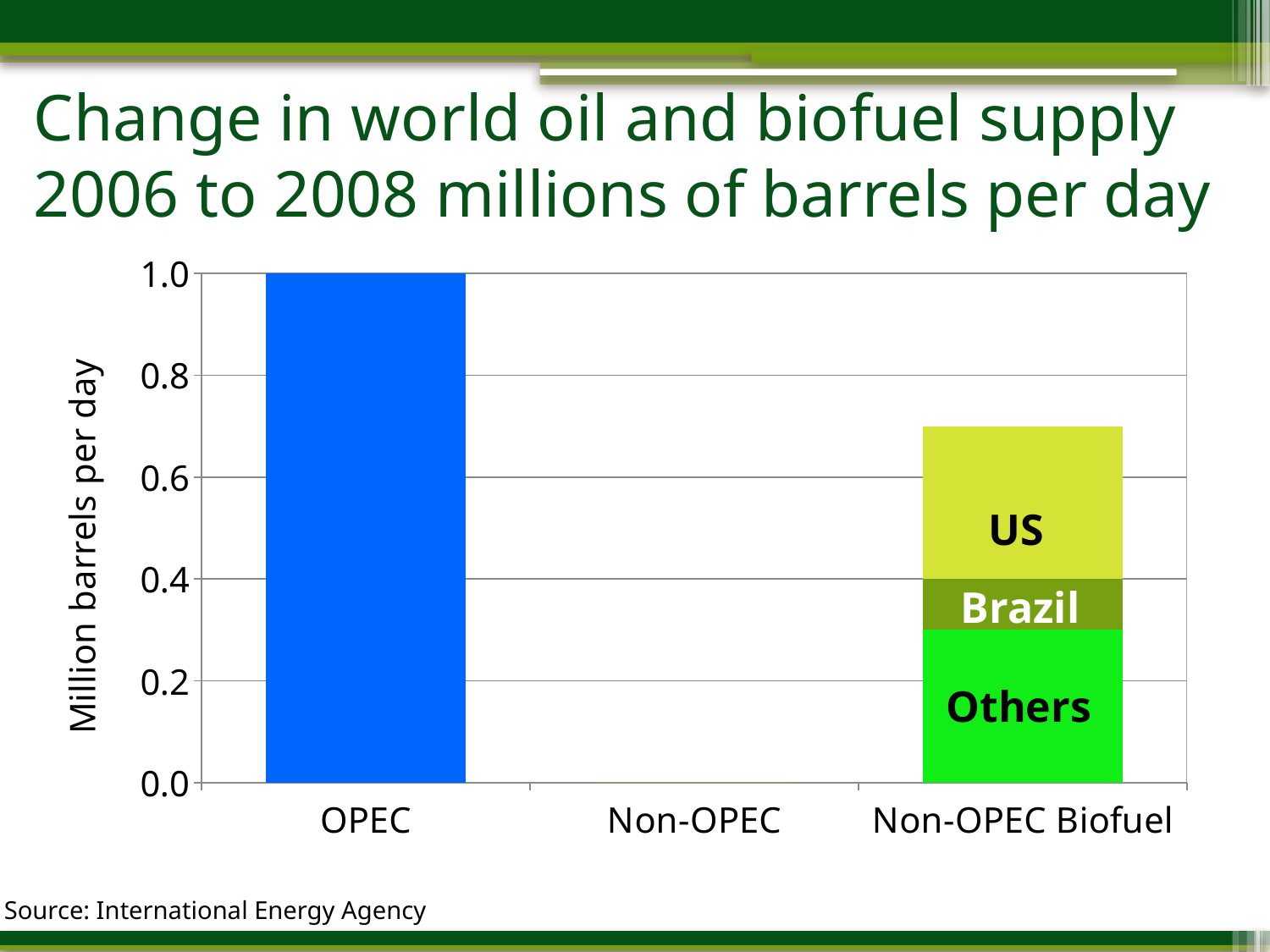
How many segments make up the Non-OPEC Biofuel bar? 3 Which category has the highest value? OPEC Is the total value for Non-OPEC Biofuel greater or less than 0.8? less What kind of chart is shown on the slide? bar chart What is the value for OPEC in million barrels per day? 1.0 Is the value for Non-OPEC greater or less than 0.2? less What is the label on the y axis? Million barrels per day Is the total value for Non-OPEC Biofuel greater or less than 0.6? greater Which is larger, the value for OPEC or the total for Non-OPEC Biofuel? OPEC Which category has the lowest value? Non-OPEC How many categories are shown on the x axis? 3